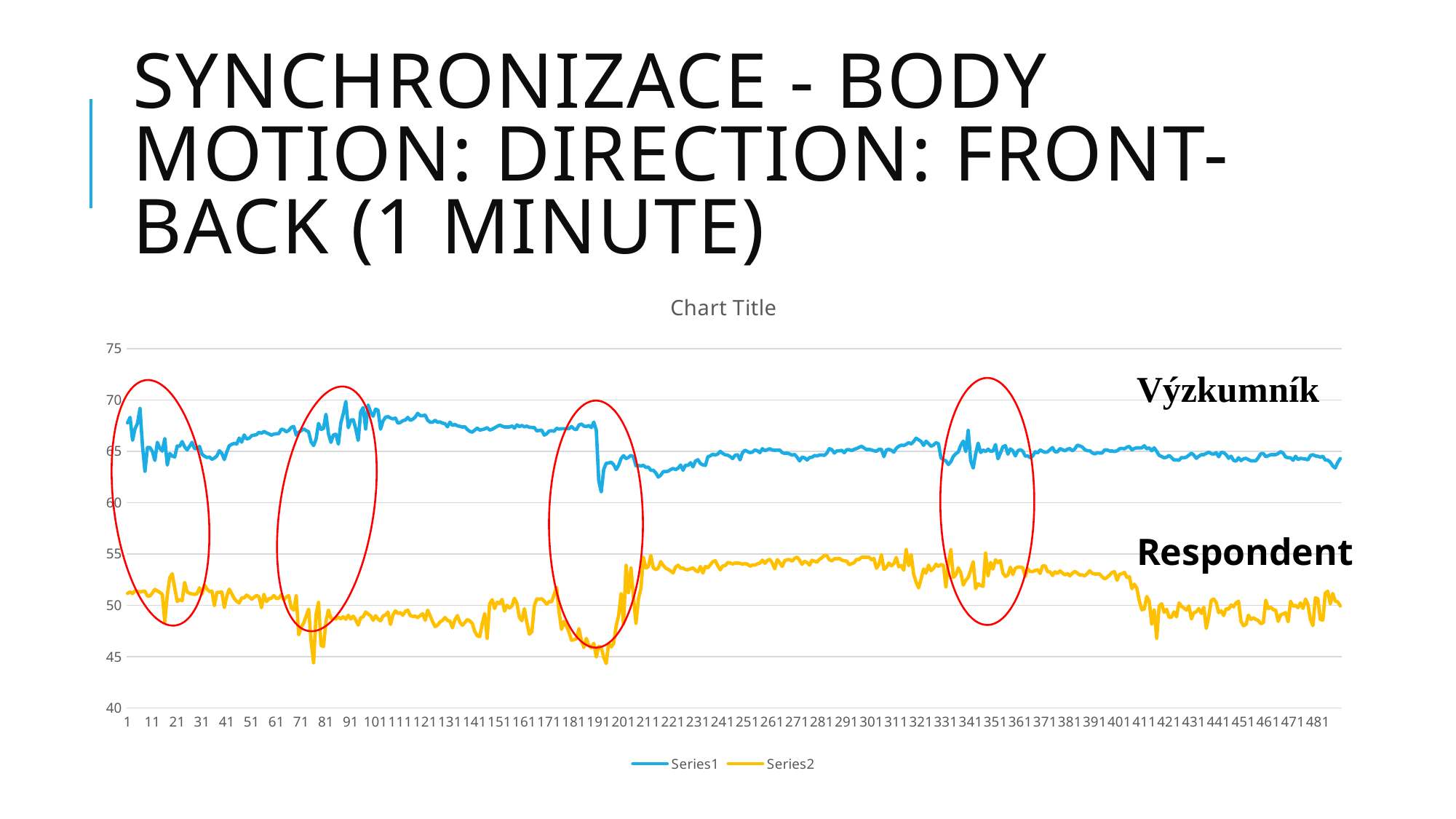
Is the value of Series1 at point 481 greater or less than 60? greater Is the value of Series2 at point 1 greater or less than 55? less What is the lowest value shown on the vertical axis? 40 What is the highest value shown on the vertical axis? 75 How many series does the legend list? 2 Is the value of Series2 at point 81 greater or less than 55? less What is the title shown above the chart? Chart Title Which series has higher values throughout the chart, Series1 or Series2? Series1 What kind of chart is shown on the slide? line chart